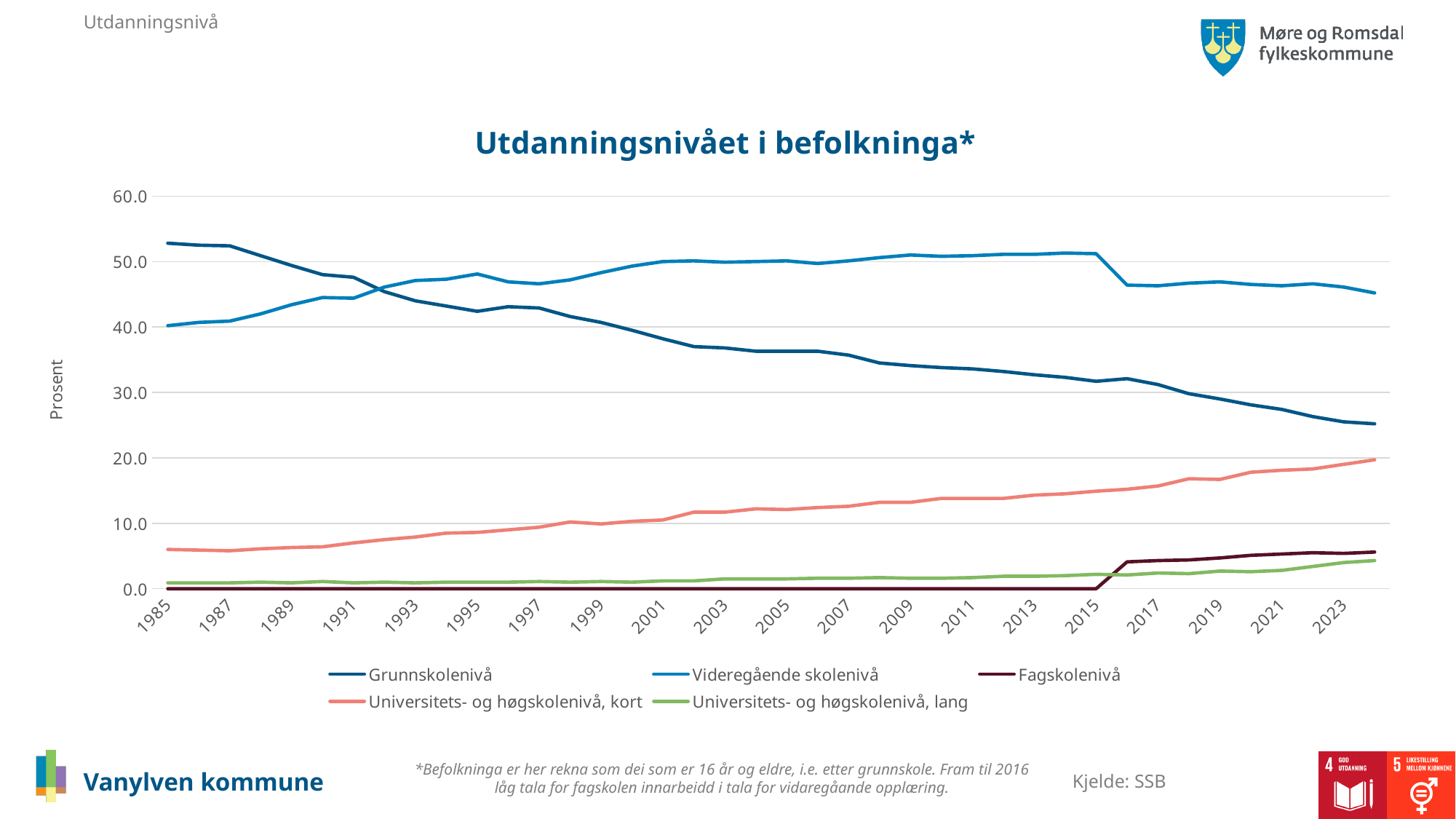
What kind of chart is shown on the slide? Line chart How many series does the legend list? 5 Is the value for Grunnskolenivå in 1985 greater or less than 50.0? greater In 2023, which is larger: Videregående skolenivå or Grunnskolenivå? Videregående skolenivå Which series has the highest value in 2023? Videregående skolenivå Is the value for Videregående skolenivå in 1985 greater or less than 50.0? less Does the value for Grunnskolenivå rise or fall from 1985 to 2023? Fall In 1985, which is larger: Grunnskolenivå or Videregående skolenivå? Grunnskolenivå Does the value for Universitets- og høgskolenivå, kort rise or fall from 1985 to 2023? Rise Is the value for Grunnskolenivå in 2023 greater or less than 30.0? less What is the label on the y axis of the chart? Prosent